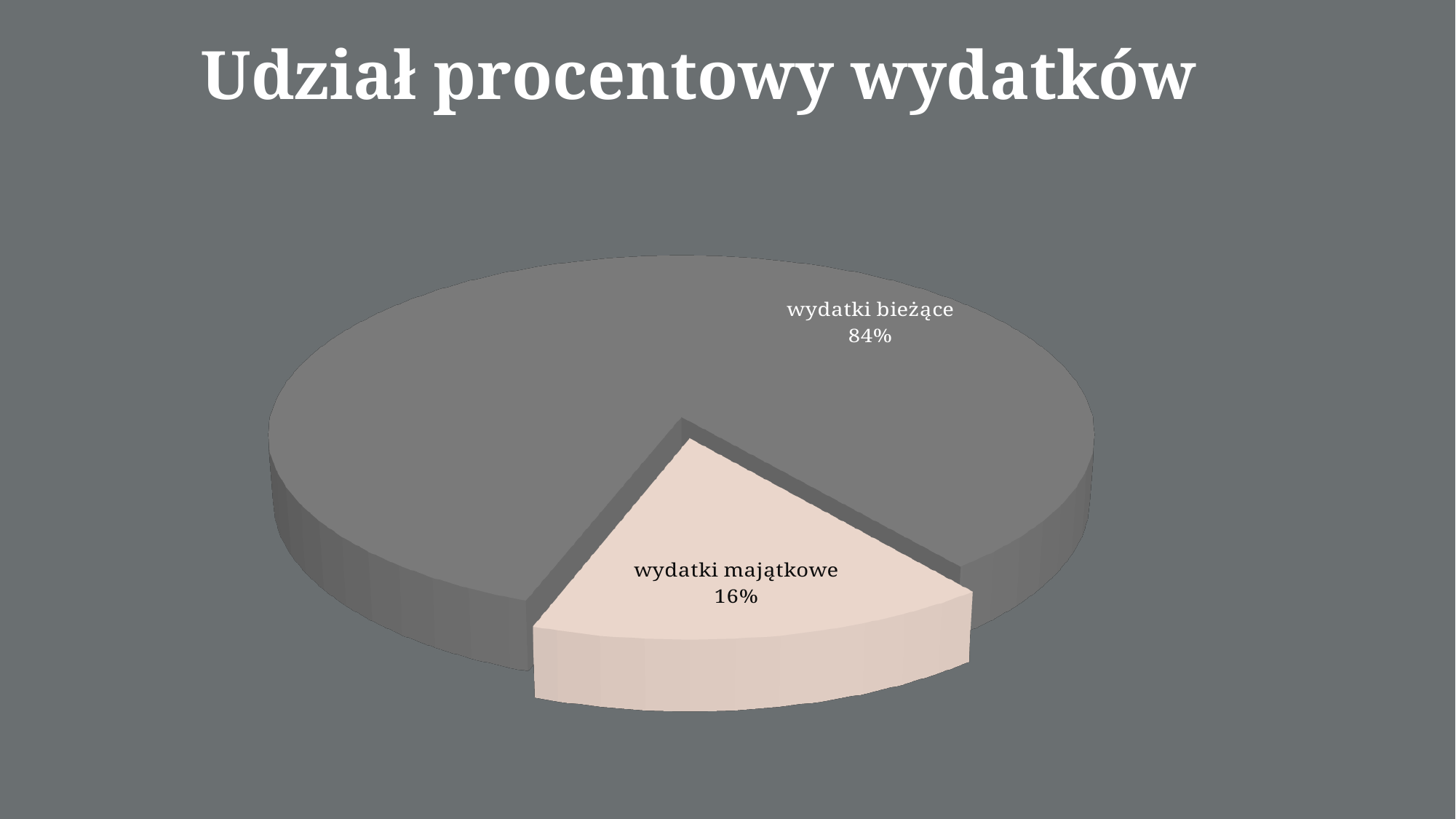
Which category has the largest slice of the pie? wydatki bieżące What is the title of the slide? Udział procentowy wydatków What share of the pie does 'wydatki bieżące' represent? 84% Which slice is pulled out (exploded) from the pie? wydatki majątkowe How many categories are shown in the pie chart? 2 What is the difference in percentage points between 'wydatki bieżące' and 'wydatki majątkowe'? 68 What kind of chart is shown on the slide? pie chart What share of the pie does 'wydatki majątkowe' represent? 16% Which category has the smallest slice of the pie? wydatki majątkowe Which is larger, 'wydatki bieżące' or 'wydatki majątkowe'? wydatki bieżące